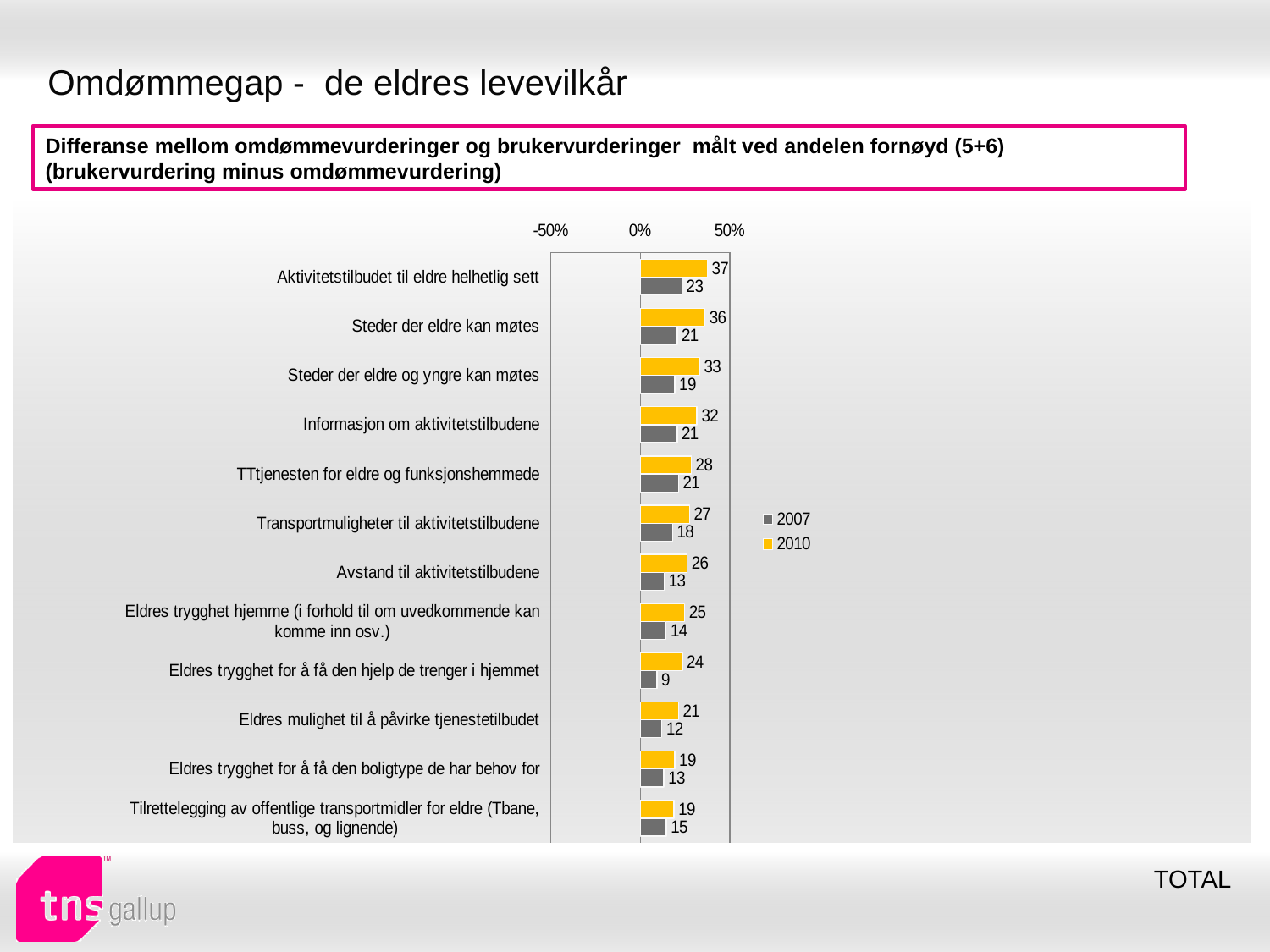
What is the 2007 value for "Eldres trygghet for å få den hjelp de trenger i hjemmet"? 9 What kind of chart is shown on the slide? Bar chart Which category has the lowest 2007 value? Eldres trygghet for å få den hjelp de trenger i hjemmet What is the 2007 value for "Avstand til aktivitetstilbudene"? 13 What is the 2010 value for "Eldres mulighet til å påvirke tjenestetilbudet"? 21 Which category has the highest 2010 value? Aktivitetstilbudet til eldre helhetlig sett How many series does the legend list? 2 What is the difference between the 2010 and 2007 values for "Steder der eldre kan møtes"? 15 Which is larger for "Transportmuligheter til aktivitetstilbudene": the 2007 value or the 2010 value? 2010 How many categories are shown in the chart? 12 Which years are listed in the chart legend? 2007 and 2010 What is the 2010 value for "Aktivitetstilbudet til eldre helhetlig sett"? 37